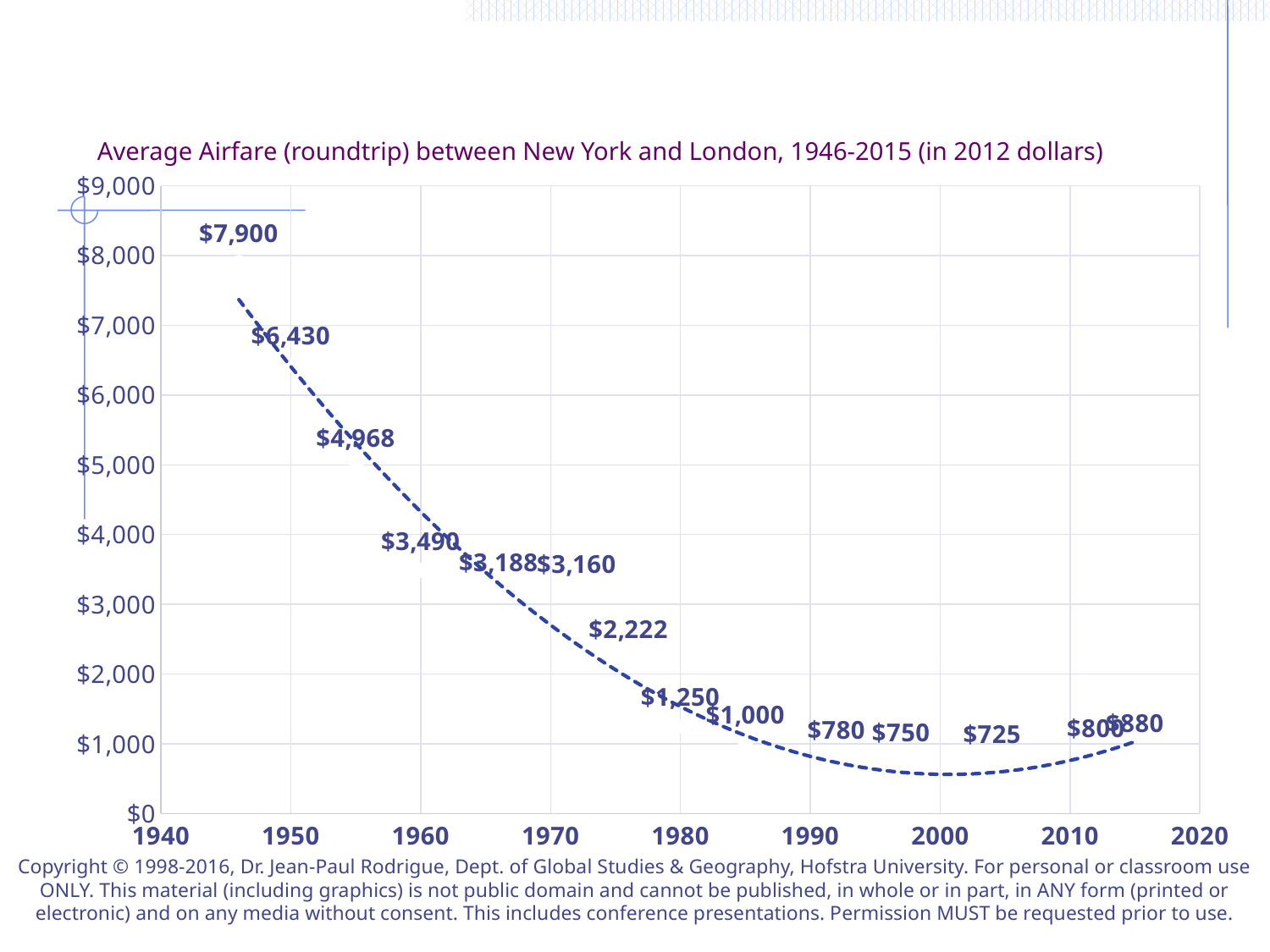
What is the lowest airfare value labeled on the chart? $725 What is the title of the chart? Average Airfare (roundtrip) between New York and London, 1946-2015 (in 2012 dollars) What is the difference between the labeled values $6,430 and $4,968? $1,462 What is the maximum value shown on the vertical axis? $9,000 Do the airfare values generally rise or fall from 1946 to 2000? fall What is the highest airfare value labeled on the chart? $7,900 What is the difference between the highest labeled airfare ($7,900) and the lowest labeled airfare ($725)? $7,175 Which is larger, the labeled value $3,188 or the labeled value $3,160? $3,188 What is the most recent (rightmost) airfare value labeled on the chart? $880 What is the earliest (leftmost) airfare value labeled on the chart? $7,900 What kind of chart is shown on the slide? scatter chart with a dashed trend line How many data labels are shown on the chart? 14